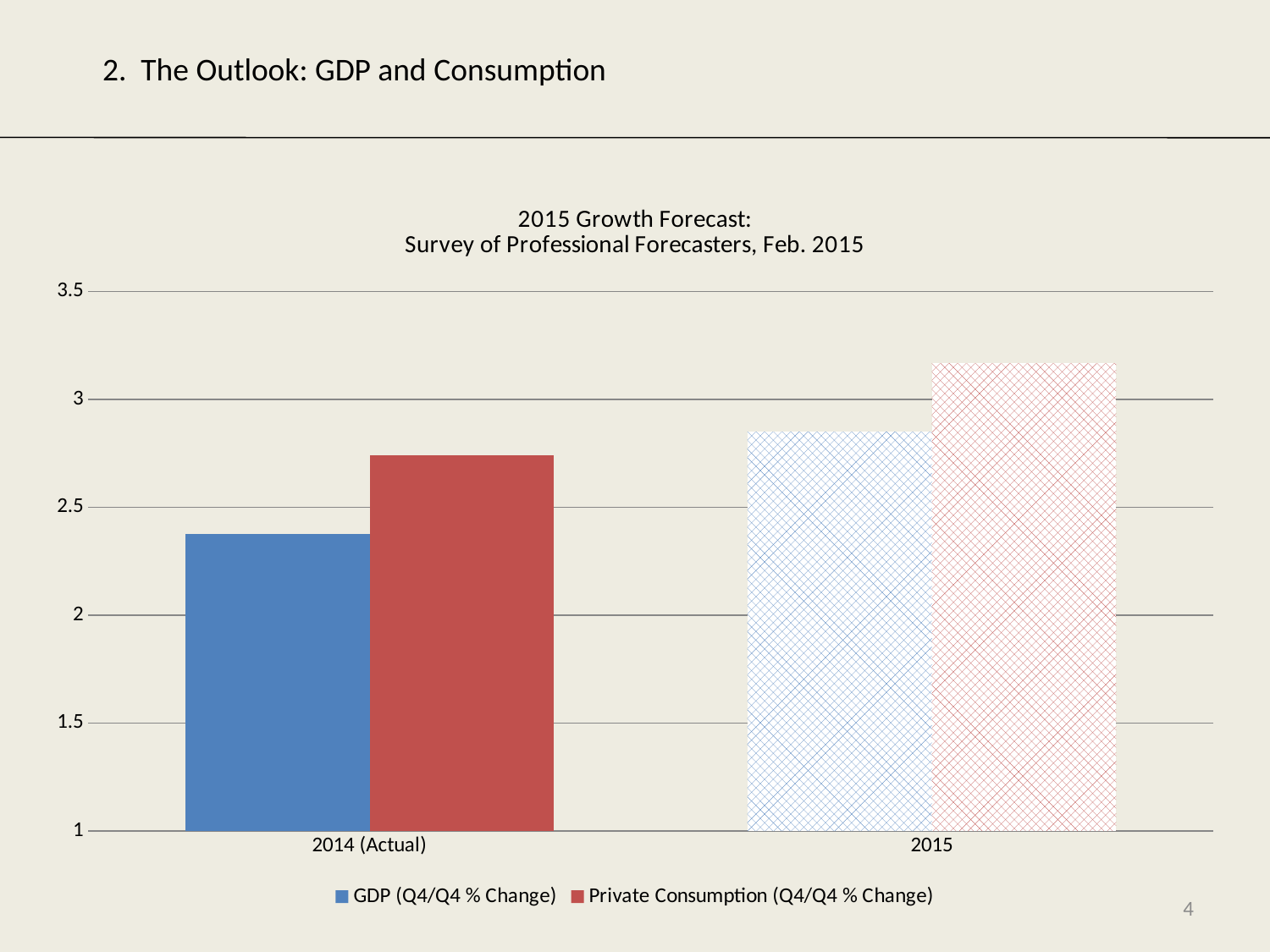
What is the title of the chart? 2015 Growth Forecast: Survey of Professional Forecasters, Feb. 2015 Which series and category has the highest bar? Private Consumption (Q4/Q4 % Change), 2015 Is the Private Consumption (Q4/Q4 % Change) value for 2015 greater or less than 3? greater Is the GDP (Q4/Q4 % Change) value for 2014 (Actual) greater or less than 2.5? less How many categories are shown on the x axis? 2 What kind of chart is shown on the slide? bar chart Is the Private Consumption (Q4/Q4 % Change) value for 2014 (Actual) greater or less than 2.5? greater Which series and category has the lowest bar? GDP (Q4/Q4 % Change), 2014 (Actual) Does the GDP (Q4/Q4 % Change) value rise or fall from 2014 (Actual) to 2015? rise How many series does the legend list? 2 For 2015, which is larger: GDP (Q4/Q4 % Change) or Private Consumption (Q4/Q4 % Change)? Private Consumption (Q4/Q4 % Change)